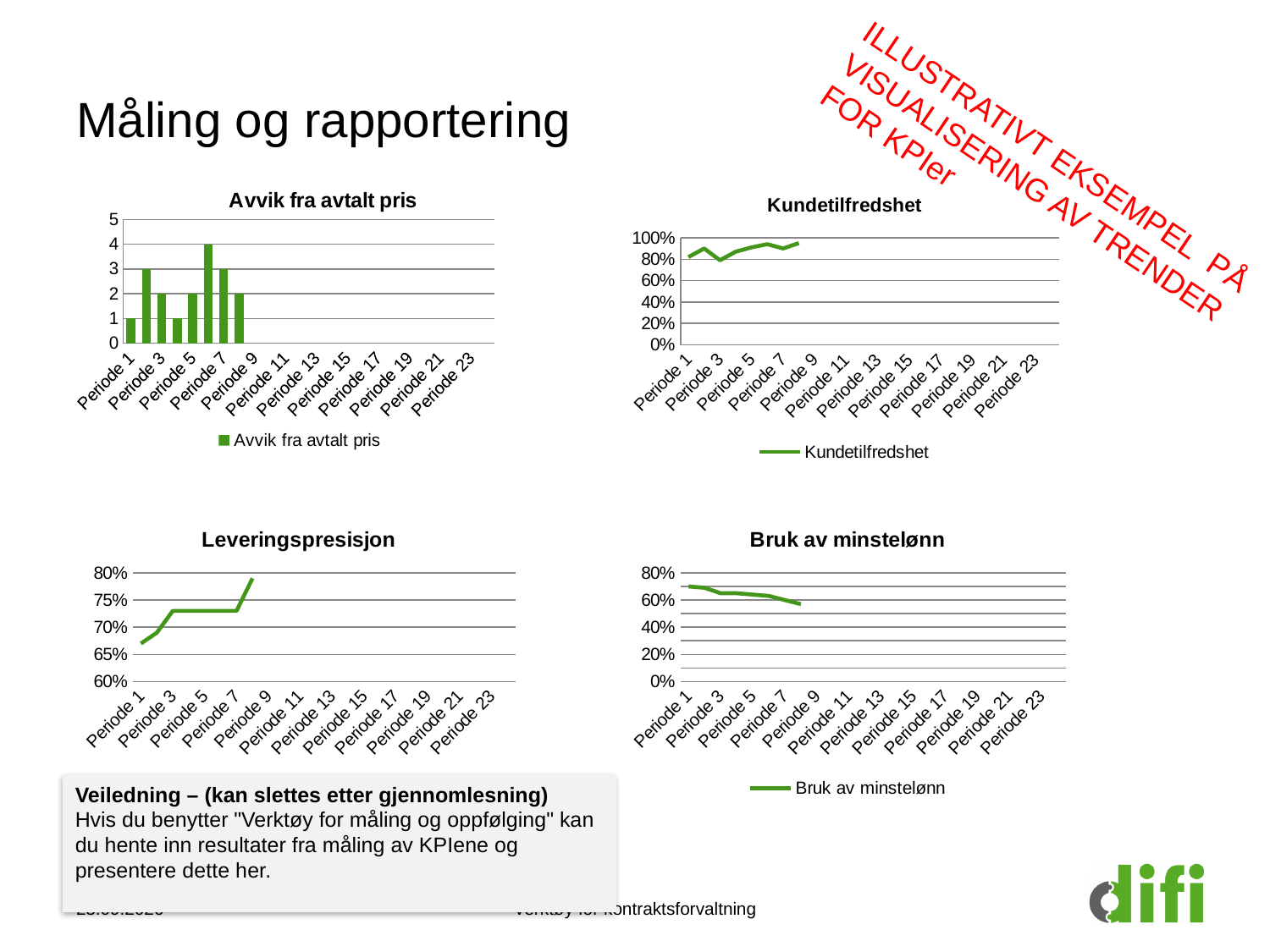
In the 'Kundetilfredshet' chart, is the value for Periode 1 greater or less than 60%? greater In the 'Avvik fra avtalt pris' chart, which period has the highest bar? Periode 6 In the 'Leveringspresisjon' chart, do the values rise or fall from Periode 1 to Periode 8? rise In the 'Avvik fra avtalt pris' chart, what is the value for Periode 6? 4 What kind of chart is 'Avvik fra avtalt pris'? bar chart In the 'Avvik fra avtalt pris' chart, what is the value for Periode 1? 1 In the 'Bruk av minstelønn' chart, do the values rise or fall from Periode 1 to Periode 8? fall What kind of chart is 'Kundetilfredshet'? line chart In the 'Avvik fra avtalt pris' chart, which is larger, the value for Periode 2 or Periode 3? Periode 2 In the 'Avvik fra avtalt pris' chart, what is the difference between the values for Periode 6 and Periode 4? 3 How many bars are plotted in the 'Avvik fra avtalt pris' chart? 8 In the 'Leveringspresisjon' chart, is the value for Periode 1 greater or less than 70%? less